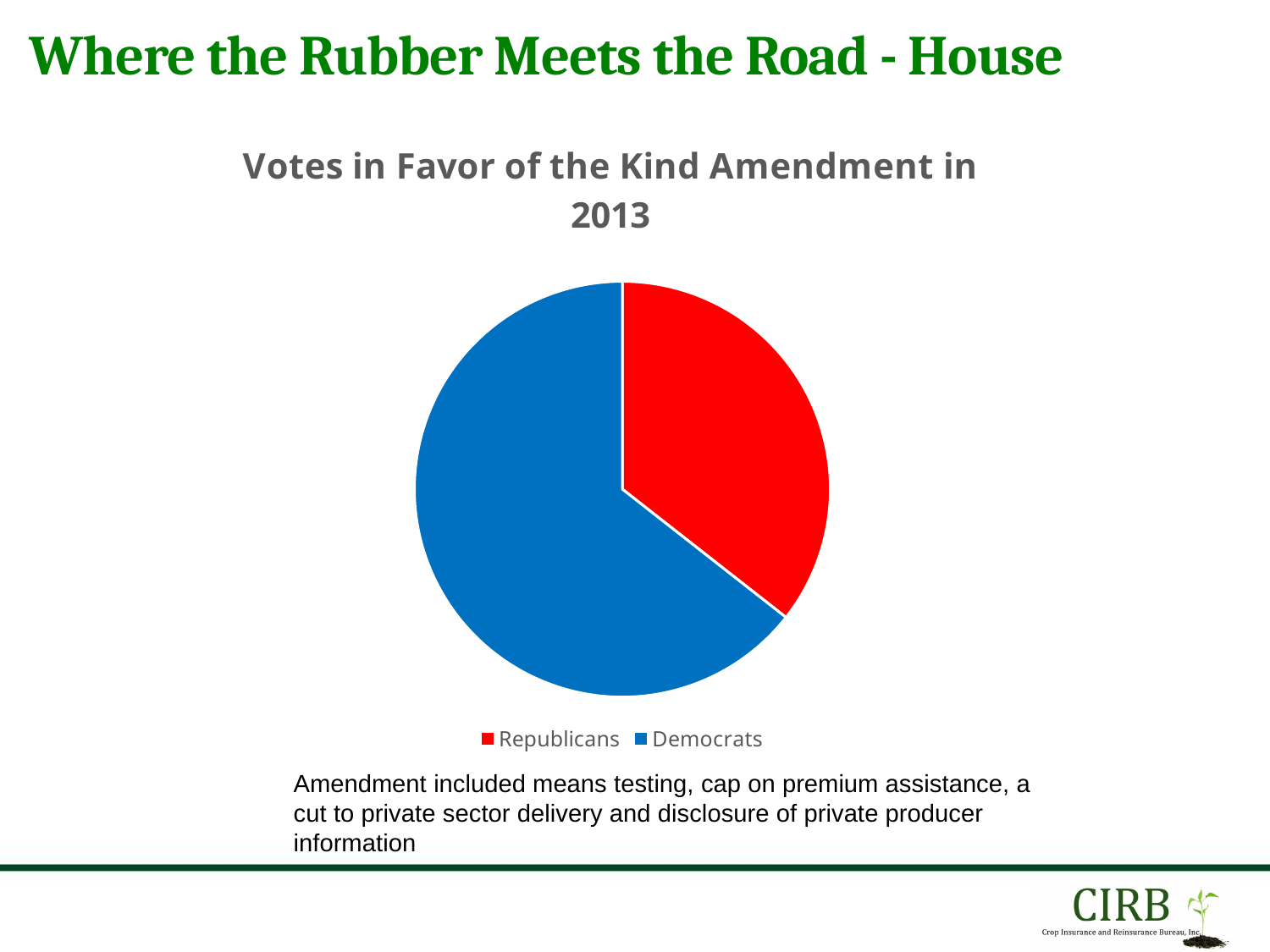
Which is larger, the Democrats slice or the Republicans slice? Democrats How many entries does the legend list? 2 Which slice is the smallest in the pie chart? Republicans What is the title of the chart? Votes in Favor of the Kind Amendment in 2013 What kind of chart is shown on the slide? pie chart How many slices does the pie chart have? 2 Is the Democrats share of the pie greater or less than 50%? greater Which slice is the largest in the pie chart? Democrats What colour is the Republicans slice? red Is the Republicans share of the pie greater or less than 50%? less